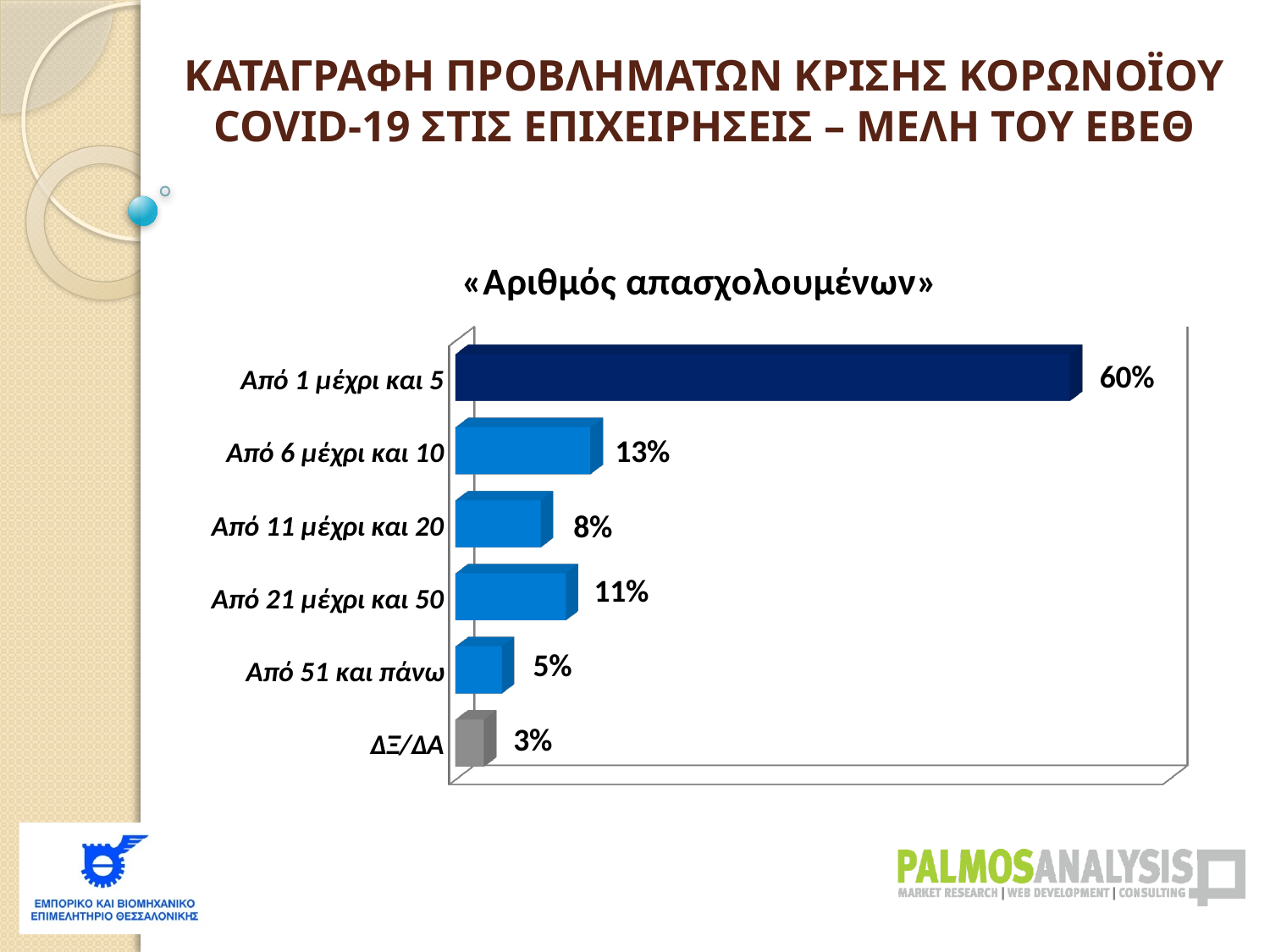
What is the value for «Από 6 μέχρι και 10»? 13% What is the difference between the values for «Από 1 μέχρι και 5» and «Από 6 μέχρι και 10»? 47% Which category has the highest value? Από 1 μέχρι και 5 How many categories are shown in the chart? 6 Which category has the lowest value? ΔΞ/ΔΑ What is the value for «ΔΞ/ΔΑ»? 3% What kind of chart is shown on the slide? Bar chart What is the value for «Από 51 και πάνω»? 5% What is the value for «Από 1 μέχρι και 5»? 60% What is the value for «Από 11 μέχρι και 20»? 8% Which is larger, the value for «Από 21 μέχρι και 50» or «Από 11 μέχρι και 20»? Από 21 μέχρι και 50 What is the value for «Από 21 μέχρι και 50»? 11%